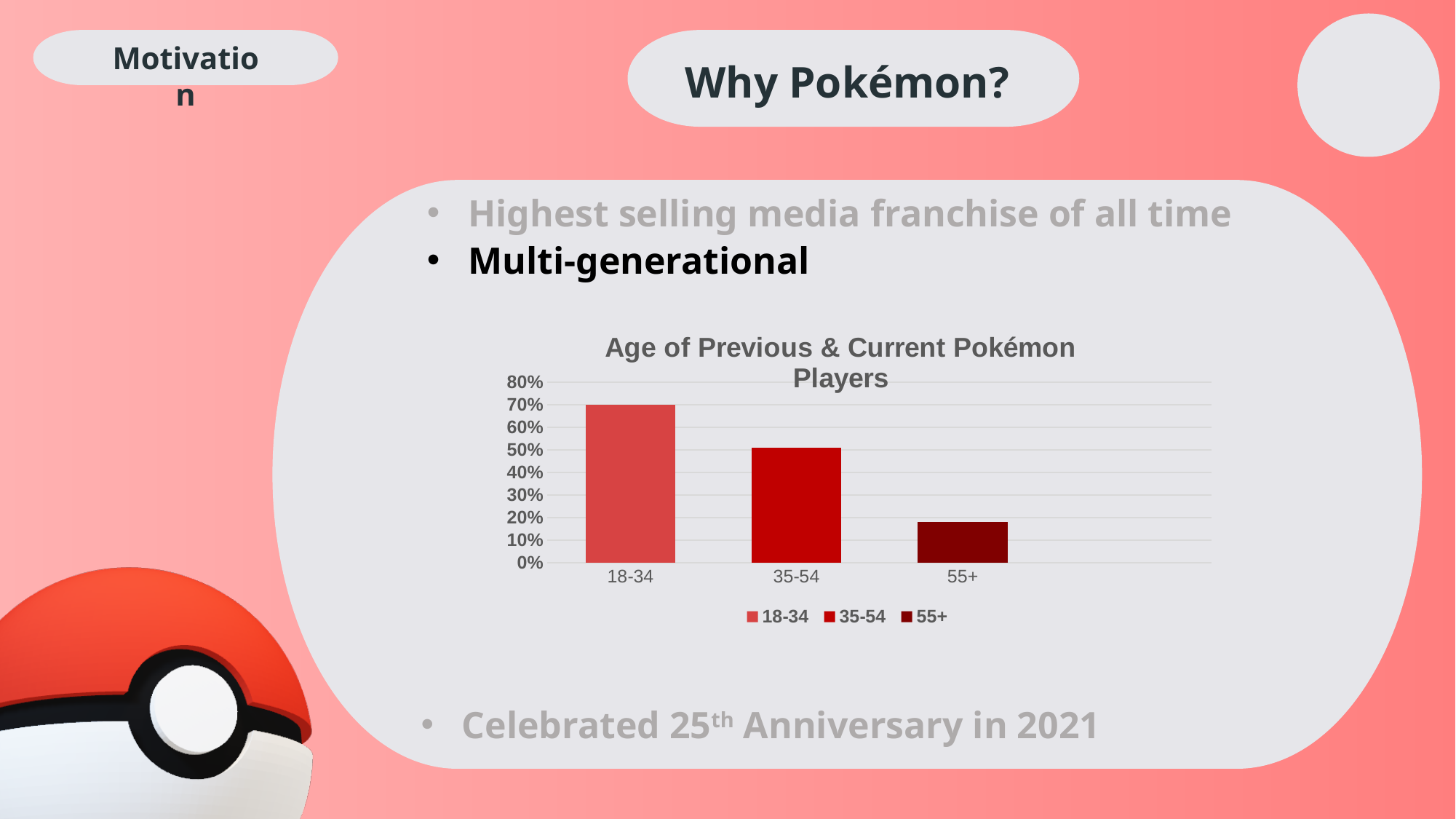
How many entries does the chart's legend list? 3 How many age categories are shown on the x axis of the chart? 3 Which age group has the lowest value in the chart? 55+ What kind of chart is shown on the slide? bar chart What is the value for the 18-34 age group? 70% Is the value for the 35-54 age group greater or less than 40%? greater Which is larger, the value for 35-54 or the value for 55+? 35-54 Which age group has the highest value in the chart? 18-34 Is the value for the 55+ age group greater or less than 30%? less What is the title of the chart? Age of Previous & Current Pokémon Players Do the values rise or fall as the age groups move from left to right along the x axis? fall Is the value for the 18-34 age group greater or less than 60%? greater